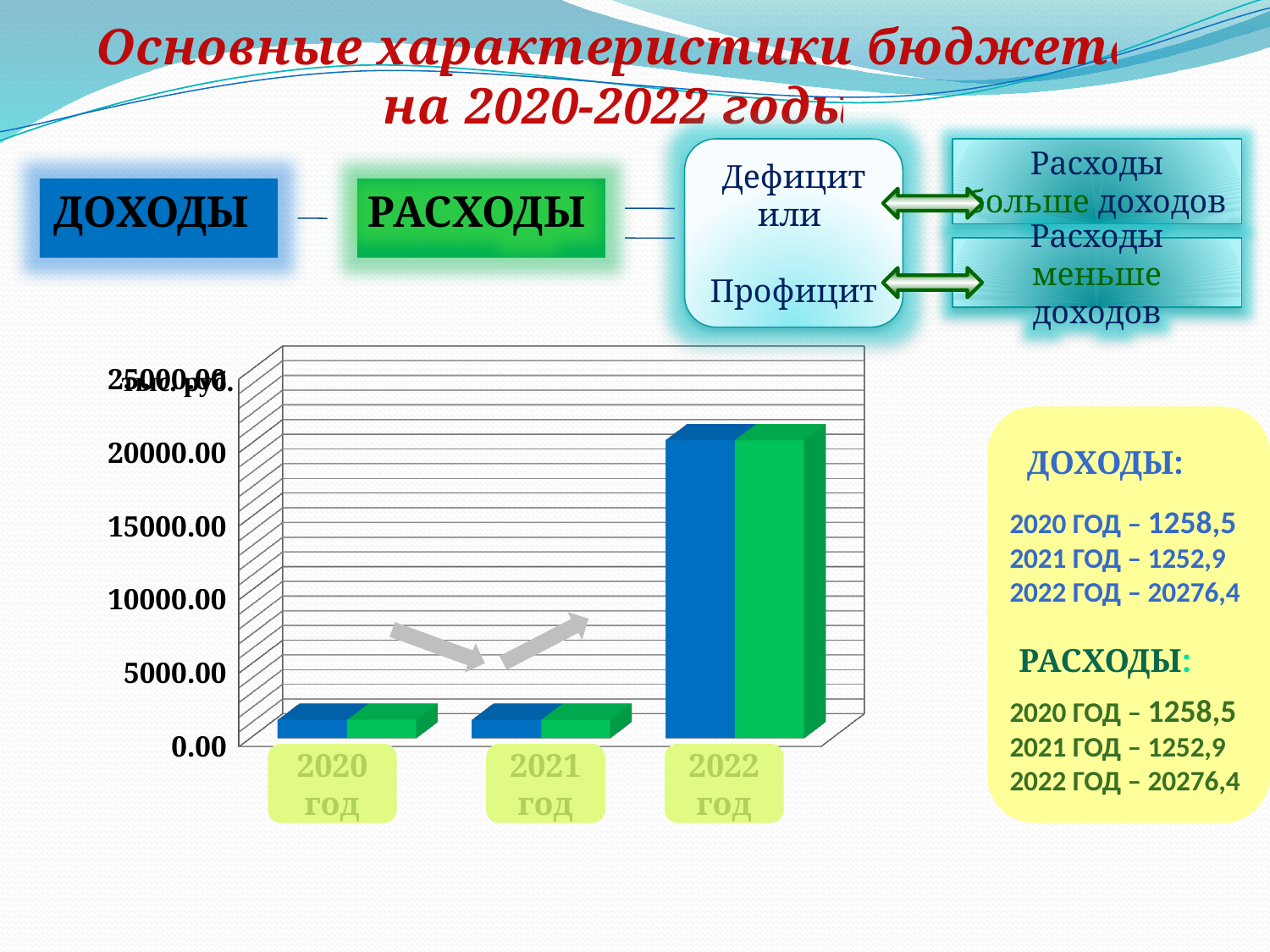
Which year has the highest bars in the chart? 2022 год Is the value for 2022 год greater or less than 15000.00? greater Is the value for 2020 год greater or less than 5000.00? less What kind of chart is shown on the slide? bar chart Which is larger in the chart, the value for 2021 год or the value for 2022 год? 2022 год According to the slide, what is the value of ДОХОДЫ for 2021 год? 1252,9 According to the slide, what is the value of ДОХОДЫ for 2022 год? 20276,4 According to the slide, what is the value of РАСХОДЫ for 2020 год? 1258,5 What colour are the ДОХОДЫ bars in the chart? blue How many bars are plotted for each year category? 2 What is the difference between ДОХОДЫ for 2022 год and ДОХОДЫ for 2020 год? 19017,9 How many year categories are shown on the x axis of the chart? 3